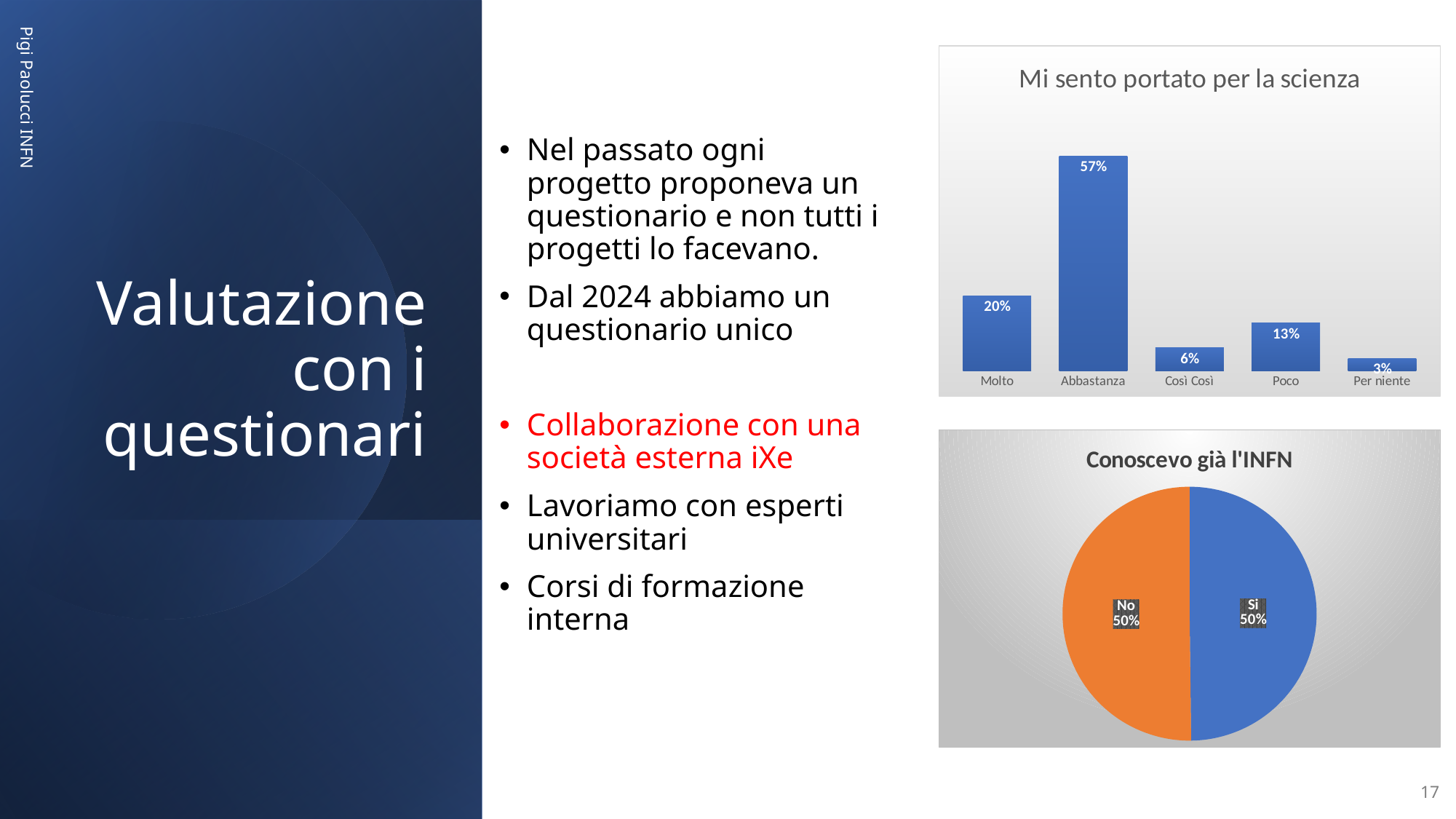
In the chart 'Mi sento portato per la scienza', what is the value for Abbastanza? 57% In the chart 'Conoscevo già l'INFN', what share of the pie is 'Si'? 50% In the chart 'Conoscevo già l'INFN', what colour is the 'No' slice? Orange What kind of chart is 'Conoscevo già l'INFN'? Pie chart In the chart 'Mi sento portato per la scienza', which category has the lowest value? Per niente In the chart 'Mi sento portato per la scienza', which category has the highest value? Abbastanza In the chart 'Mi sento portato per la scienza', what is the value for Poco? 13% What kind of chart is 'Mi sento portato per la scienza'? Bar chart In the chart 'Mi sento portato per la scienza', which is larger, Poco or Così Così? Poco In the chart 'Mi sento portato per la scienza', what is the value for Molto? 20% How many categories are shown in the chart 'Mi sento portato per la scienza'? 5 In the chart 'Mi sento portato per la scienza', what is the difference between Abbastanza and Molto? 37%